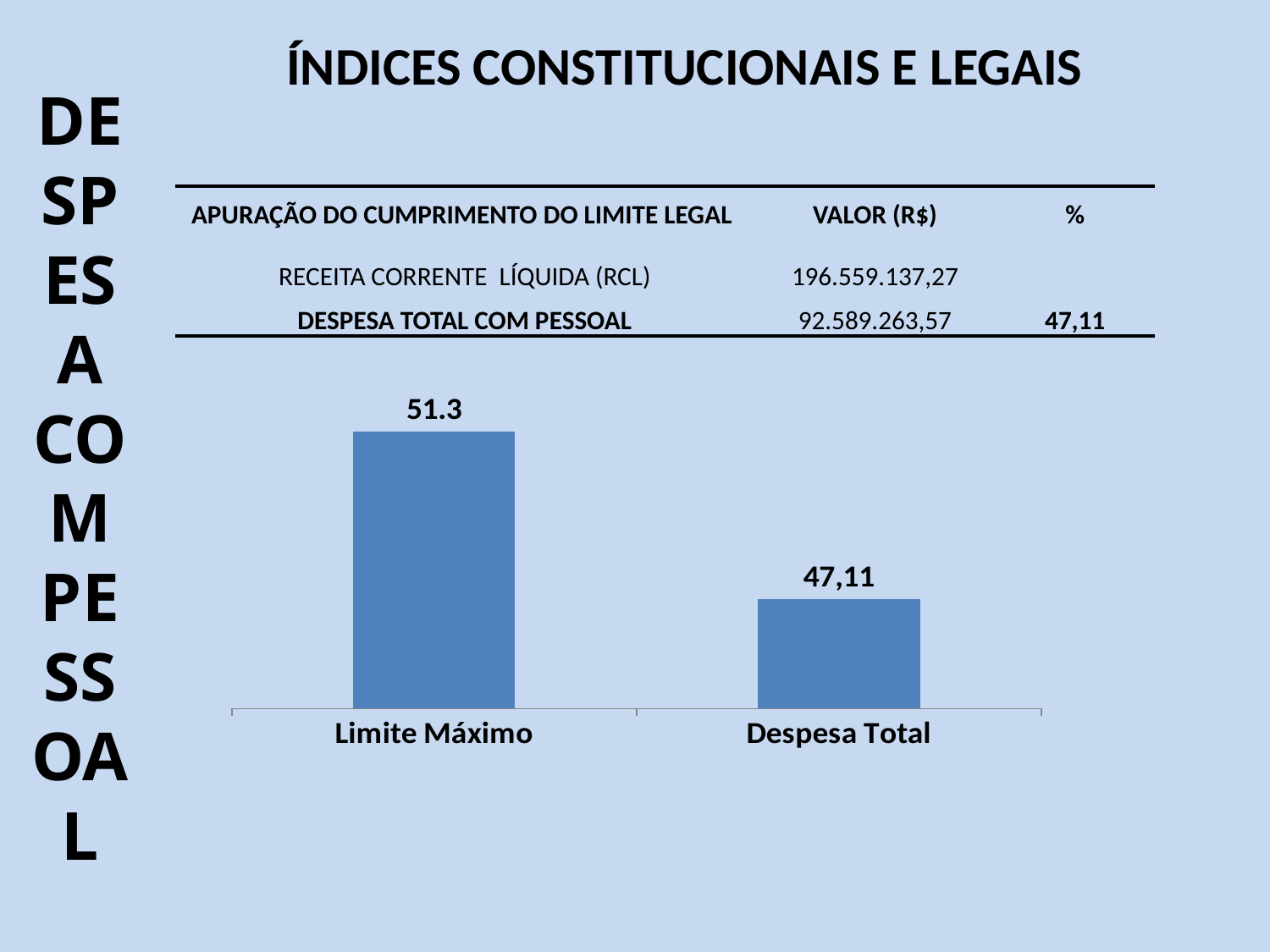
What are the two category labels on the x axis of the bar chart? Limite Máximo and Despesa Total What colour are the bars in the chart? Blue What is the value shown for Despesa Total in the bar chart? 47,11 What is the value shown for Limite Máximo in the bar chart? 51.3 How many bars are plotted in the chart? 2 What kind of chart is shown on the slide? Bar chart Which category has the highest bar in the chart? Limite Máximo Which is larger in the bar chart, Limite Máximo or Despesa Total? Limite Máximo Which category has the lowest bar in the chart? Despesa Total Do the bar values rise or fall from Limite Máximo to Despesa Total? Fall